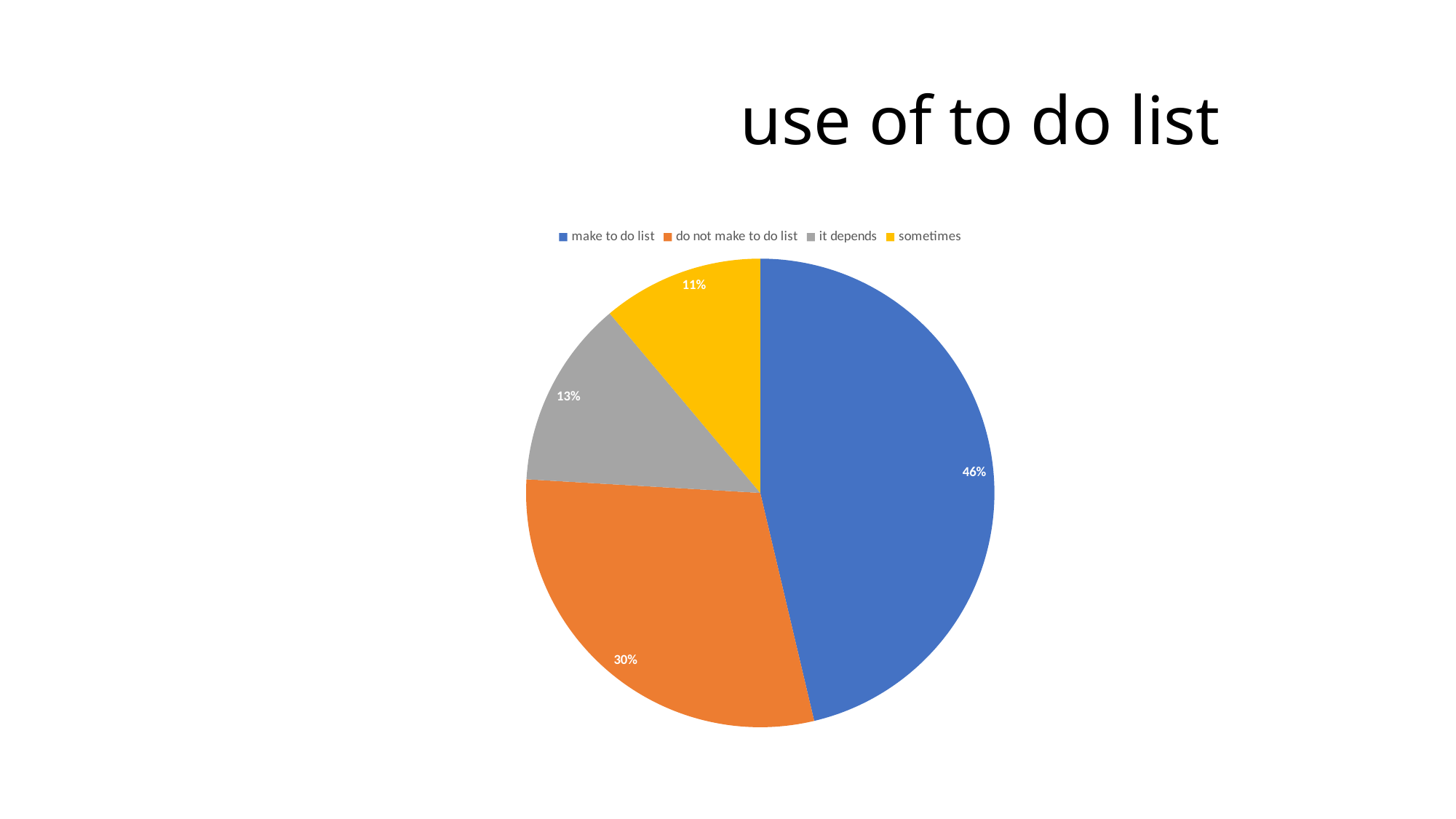
What colour is the 'sometimes' slice? yellow How many slices does the pie chart have? 4 Which category has the largest share of the pie? make to do list Which category has the smallest share of the pie? sometimes What percentage of the pie is 'it depends'? 13% Which is larger, the share for 'it depends' or the share for 'sometimes'? it depends What percentage of the pie is 'sometimes'? 11% What percentage of the pie is 'do not make to do list'? 30% What kind of chart is shown on the slide? pie chart What is the difference in percentage points between 'make to do list' and 'do not make to do list'? 16 What is the title of the slide? use of to do list What percentage of the pie is 'make to do list'? 46%